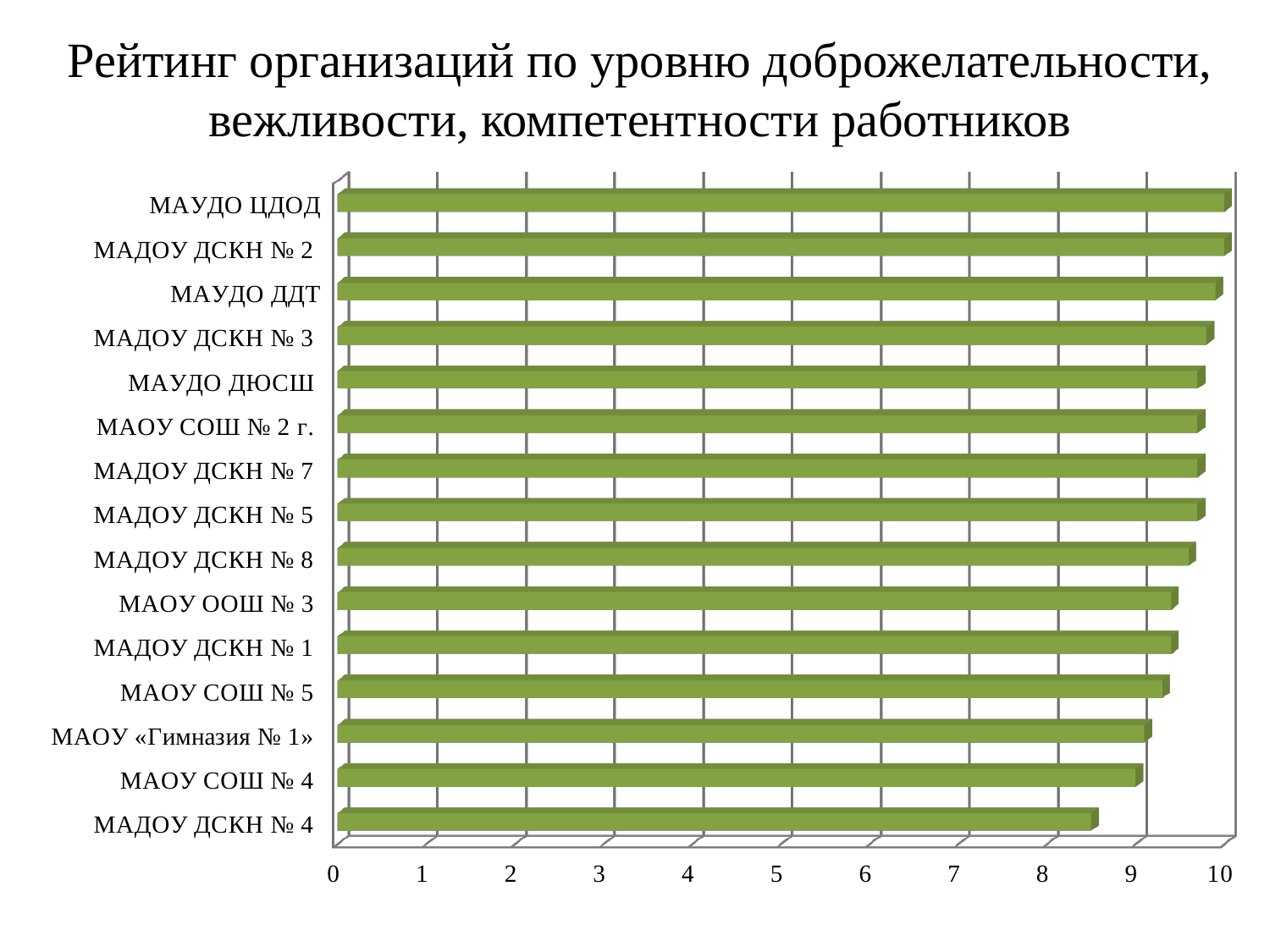
Do the bar values increase or decrease going from the top of the chart to the bottom? decrease Which is larger, the value for МАУДО ЦДОД or the value for МАДОУ ДСКН № 4? МАУДО ЦДОД Is the value for МАУДО ЦДОД greater or less than 8? greater Is the value for МАДОУ ДСКН № 4 greater or less than 9? less How many organisations are listed on the chart? 15 Which is larger, the value for МАДОУ ДСКН № 8 or the value for МАОУ СОШ № 5? МАДОУ ДСКН № 8 Is the value for МАДОУ ДСКН № 8 greater or less than 9? greater What is the maximum value shown on the horizontal axis of the chart? 10 Which organisation has the lowest rating on the chart? МАДОУ ДСКН № 4 What colour are the bars on the chart? green What kind of chart is shown on the slide? bar chart